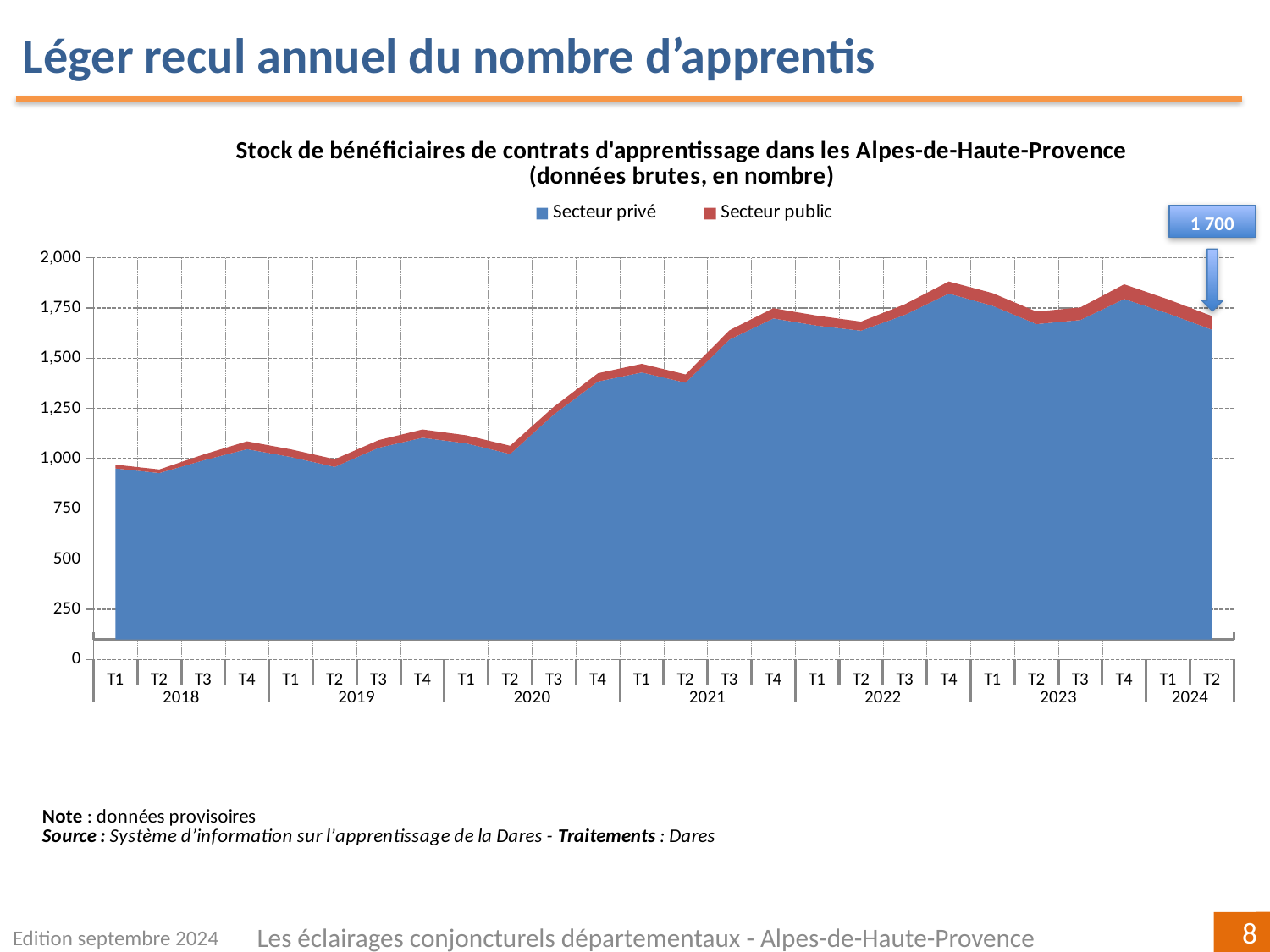
What kind of chart is shown on the slide? Area chart Is the total value for T4 2022 greater or less than 1,750? greater What are the two series named in the legend? Secteur privé and Secteur public Overall, does the total stock of apprentices rise or fall from 2018 to 2024? Rise Which series is larger in every quarter, Secteur privé or Secteur public? Secteur privé Is the total value for T1 2021 greater or less than 1,250? greater How many series does the legend list? 2 Which quarter has the larger total, T4 2019 or T4 2021? T4 2021 Is the total value for T2 2020 greater or less than 1,250? less How many quarters are plotted along the x axis? 26 What value does the callout give for the total stock of apprentices in T2 2024? 1 700